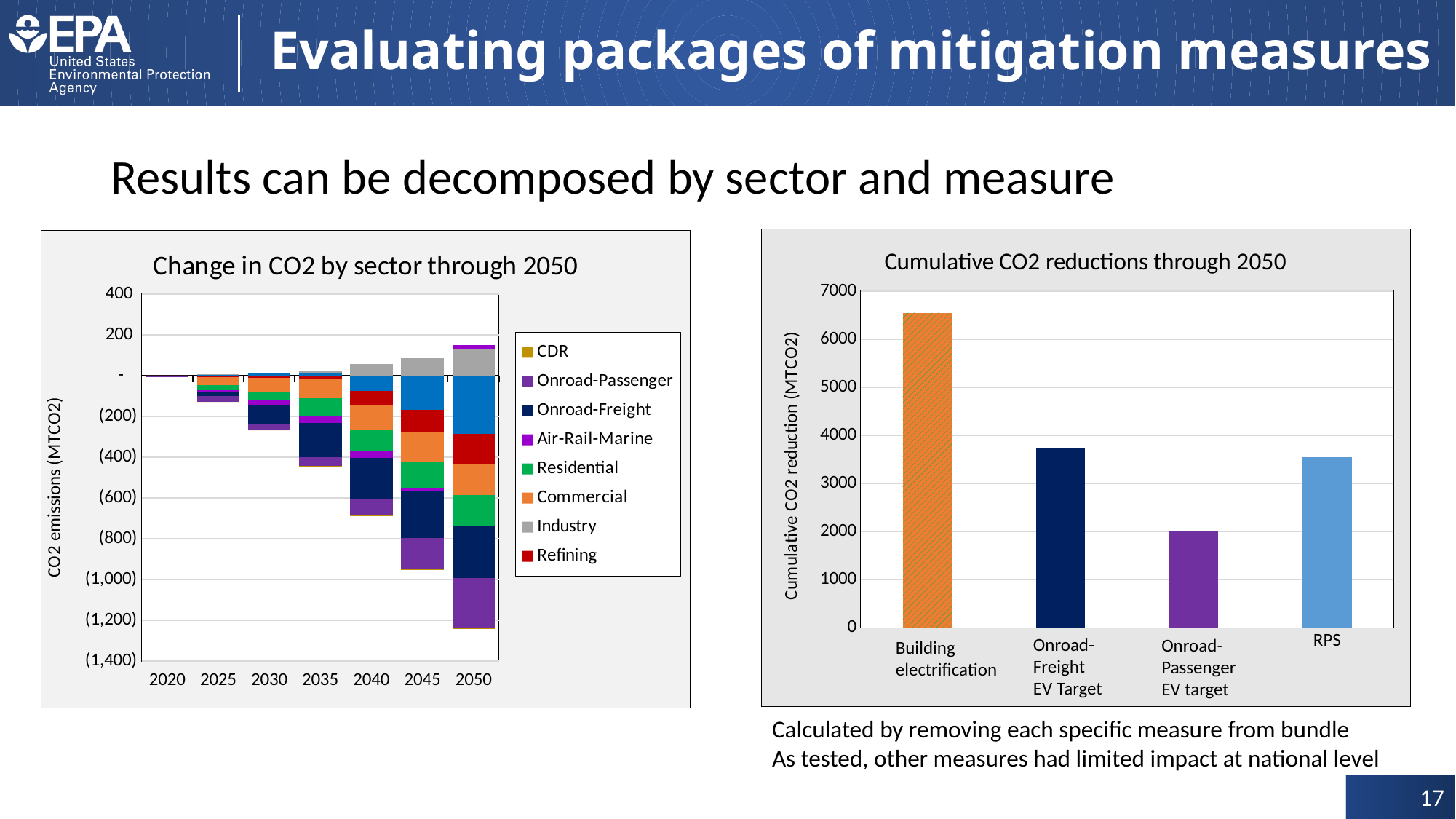
What kind of chart is 'Cumulative CO2 reductions through 2050'? Bar chart How many measures are shown on the 'Cumulative CO2 reductions through 2050' chart? 4 On the 'Cumulative CO2 reductions through 2050' chart, which measure has the lowest cumulative CO2 reduction? Onroad-Passenger EV target On the 'Cumulative CO2 reductions through 2050' chart, is the value for Onroad-Passenger EV target greater or less than 3000? less How many series does the legend of the 'Change in CO2 by sector through 2050' chart list? 8 How many years are shown on the x axis of the 'Change in CO2 by sector through 2050' chart? 7 What is the y-axis label of the 'Change in CO2 by sector through 2050' chart? CO2 emissions (MTCO2) On the 'Cumulative CO2 reductions through 2050' chart, which is larger, Building electrification or RPS? Building electrification On the 'Cumulative CO2 reductions through 2050' chart, which measure has the highest cumulative CO2 reduction? Building electrification On the 'Change in CO2 by sector through 2050' chart, do the total CO2 changes rise or fall from 2020 to 2050? Fall On the 'Cumulative CO2 reductions through 2050' chart, is the value for Building electrification greater or less than 6000? greater On the 'Cumulative CO2 reductions through 2050' chart, is the value for RPS greater or less than 3000? greater